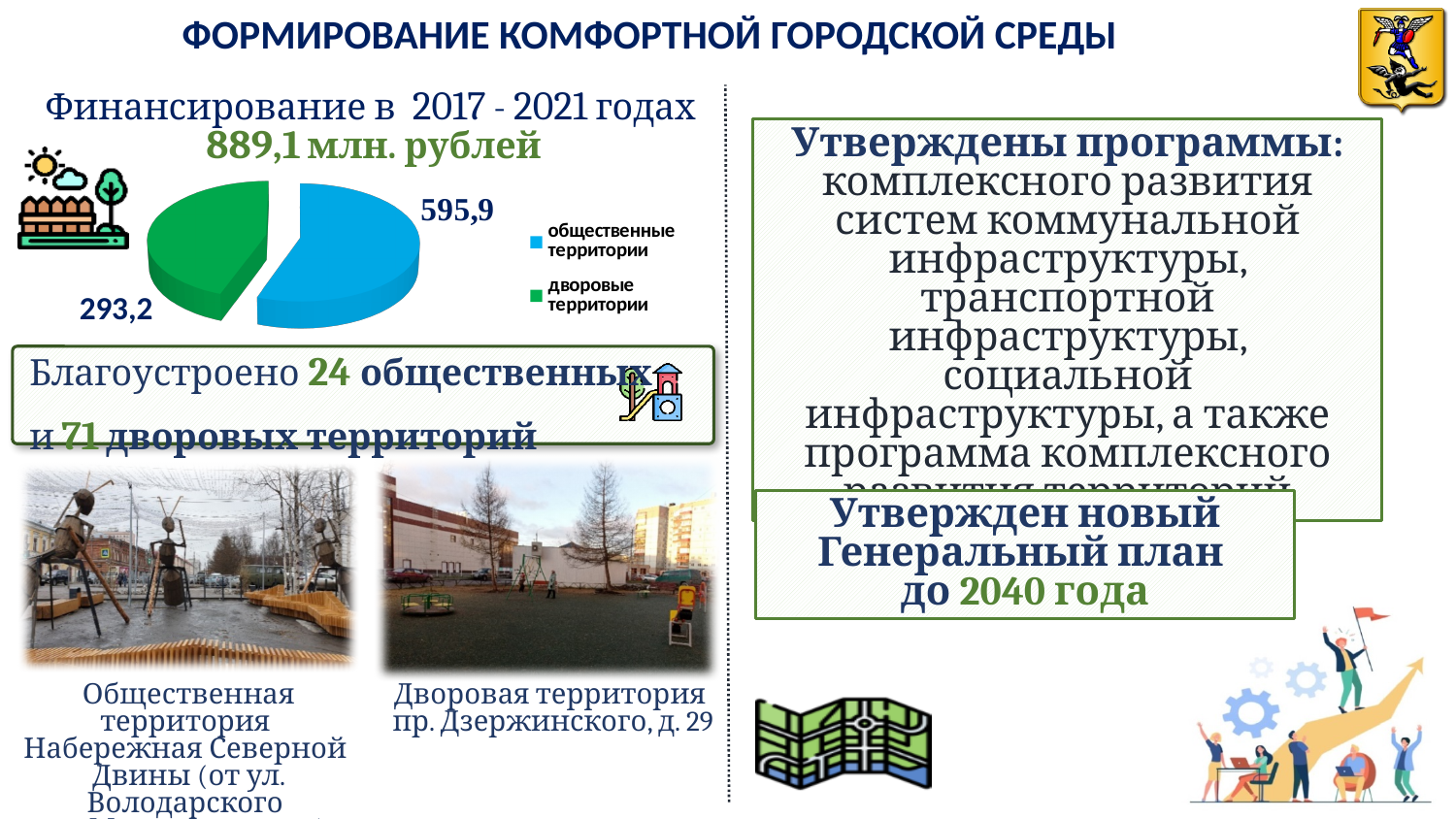
How many slices does the pie chart have? 2 Which category has the largest slice in the pie chart? общественные территории What is the value for дворовые территории in the pie chart? 293,2 What colour is the slice for дворовые территории? green Which is larger: the value for общественные территории or for дворовые территории? общественные территории What is the total of the two slices in the pie chart, as stated on the slide? 889,1 млн. рублей What period does the financing shown in the pie chart cover? 2017 - 2021 Which category has the smallest slice in the pie chart? дворовые территории How many entries does the legend of the pie chart list? 2 What type of chart is shown on the slide? pie chart What is the value for общественные территории in the pie chart? 595,9 What is the difference between the values for общественные территории and дворовые территории? 302,7